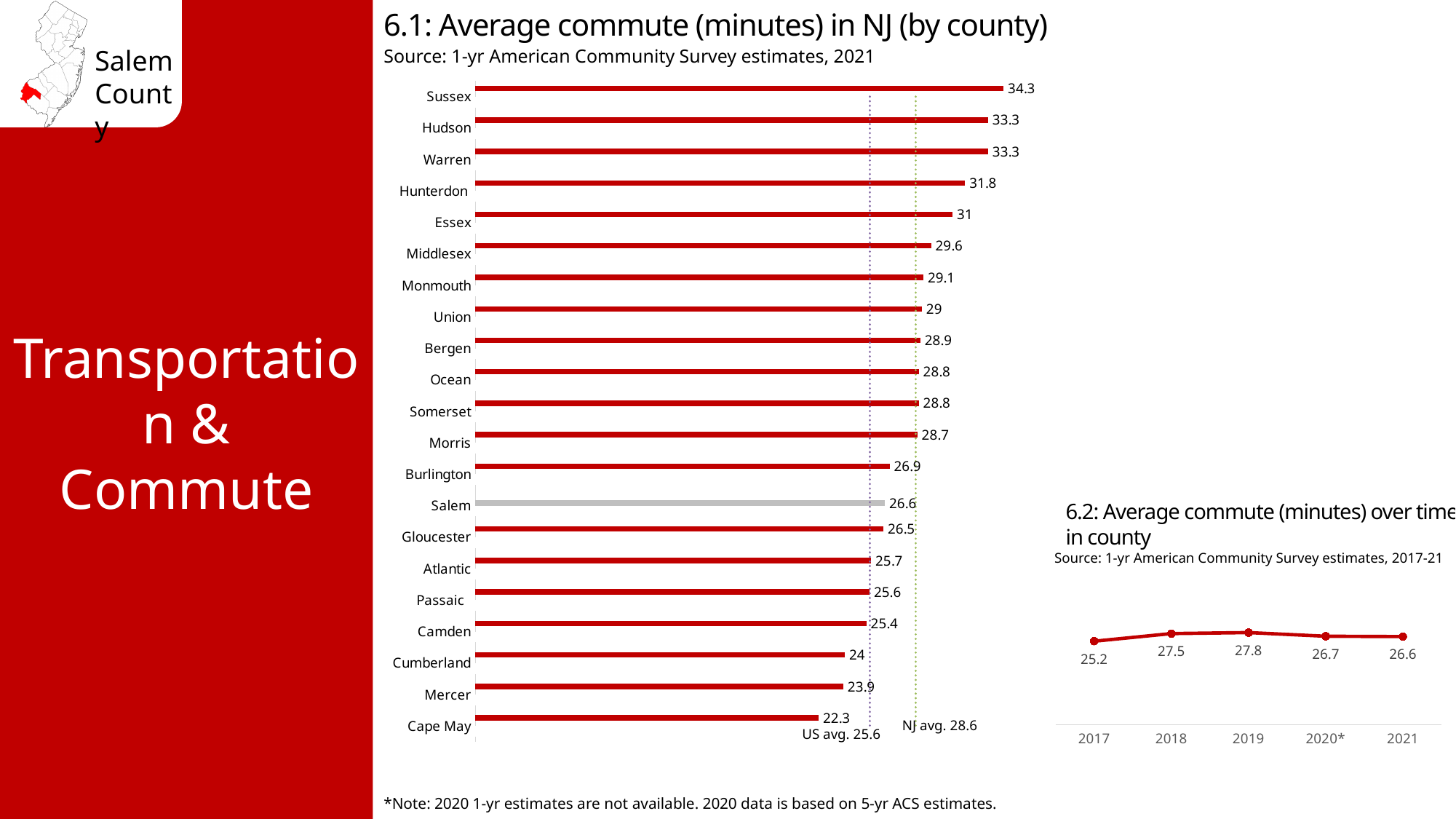
In chart 6.1 (Average commute in NJ by county), what is the difference between Sussex and Cape May? 12 In chart 6.1 (Average commute in NJ by county), which county has the highest average commute? Sussex In chart 6.1 (Average commute in NJ by county), what is the average commute for Salem? 26.6 In chart 6.1 (Average commute in NJ by county), what is the NJ average commute shown by the reference line? 28.6 In chart 6.2 (Average commute over time in county), what is the value for 2019? 27.8 In chart 6.1 (Average commute in NJ by county), which county has the lowest average commute? Cape May In chart 6.1 (Average commute in NJ by county), how many counties are shown? 21 In chart 6.2 (Average commute over time in county), how many data points are plotted? 5 In chart 6.1 (Average commute in NJ by county), what is the average commute for Hunterdon? 31.8 In chart 6.1 (Average commute in NJ by county), which has the larger average commute, Burlington or Gloucester? Burlington What type of chart is chart 6.1 (Average commute in NJ by county)? Bar chart In chart 6.2 (Average commute over time in county), which year has the lowest value? 2017